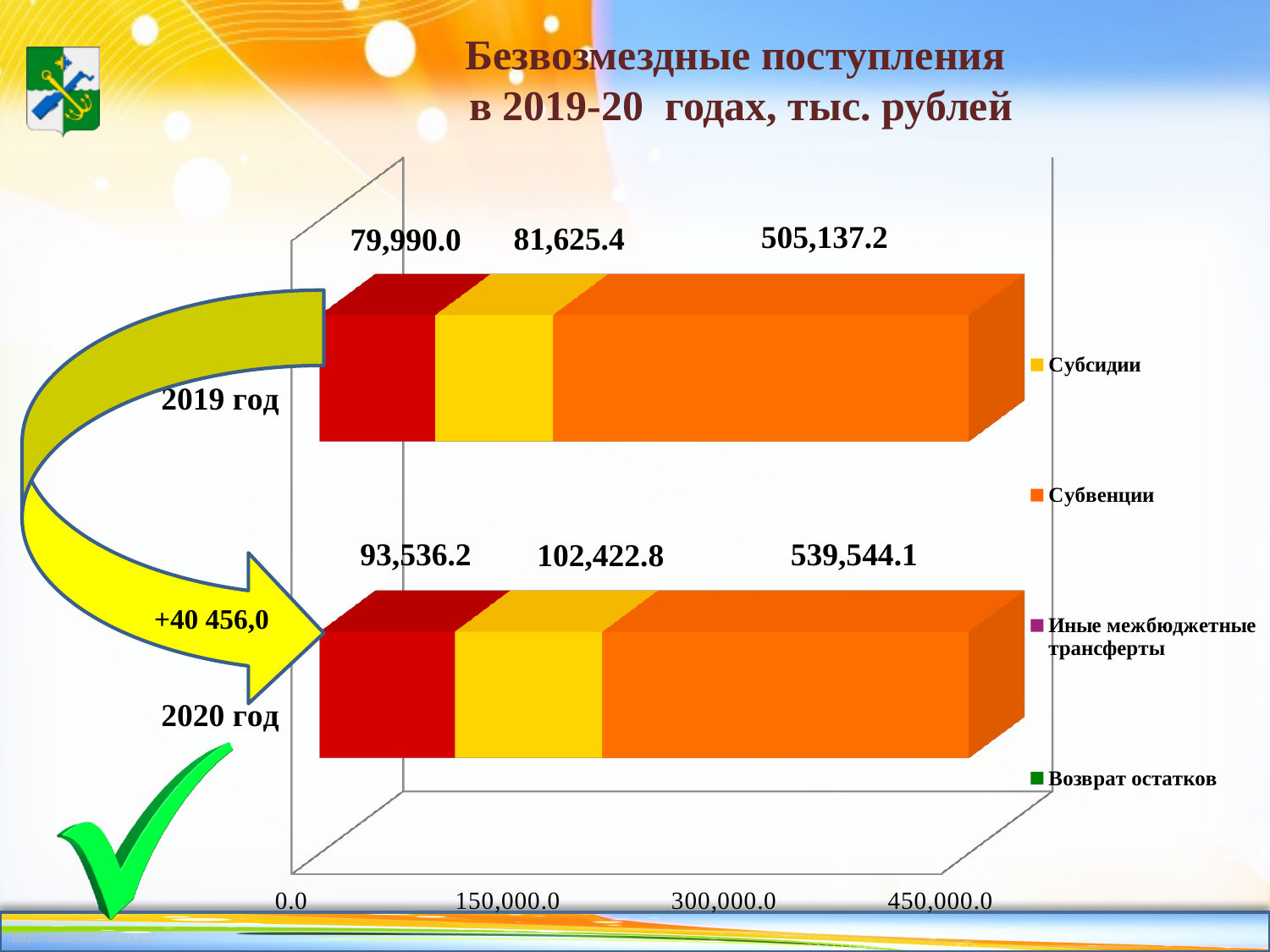
Which segment has the largest value in the 2019 год bar? Субвенции Which year has the larger value for Субсидии, 2019 год or 2020 год? 2020 год How many entries does the legend list? 4 What is the value of Субсидии for 2020 год? 102,422.8 What is the value printed on the first (red) segment of the 2020 год bar? 93,536.2 By how much did Субсидии increase from 2019 год to 2020 год? 20,797.4 What type of chart is shown on the slide? Stacked bar chart What is the value of Субвенции for 2020 год? 539,544.1 How many bars (years) are shown in the chart? 2 By how much did Субвенции increase from 2019 год to 2020 год? 34,406.9 What is the value of Субсидии for 2019 год? 81,625.4 What is the value of Субвенции for 2019 год? 505,137.2